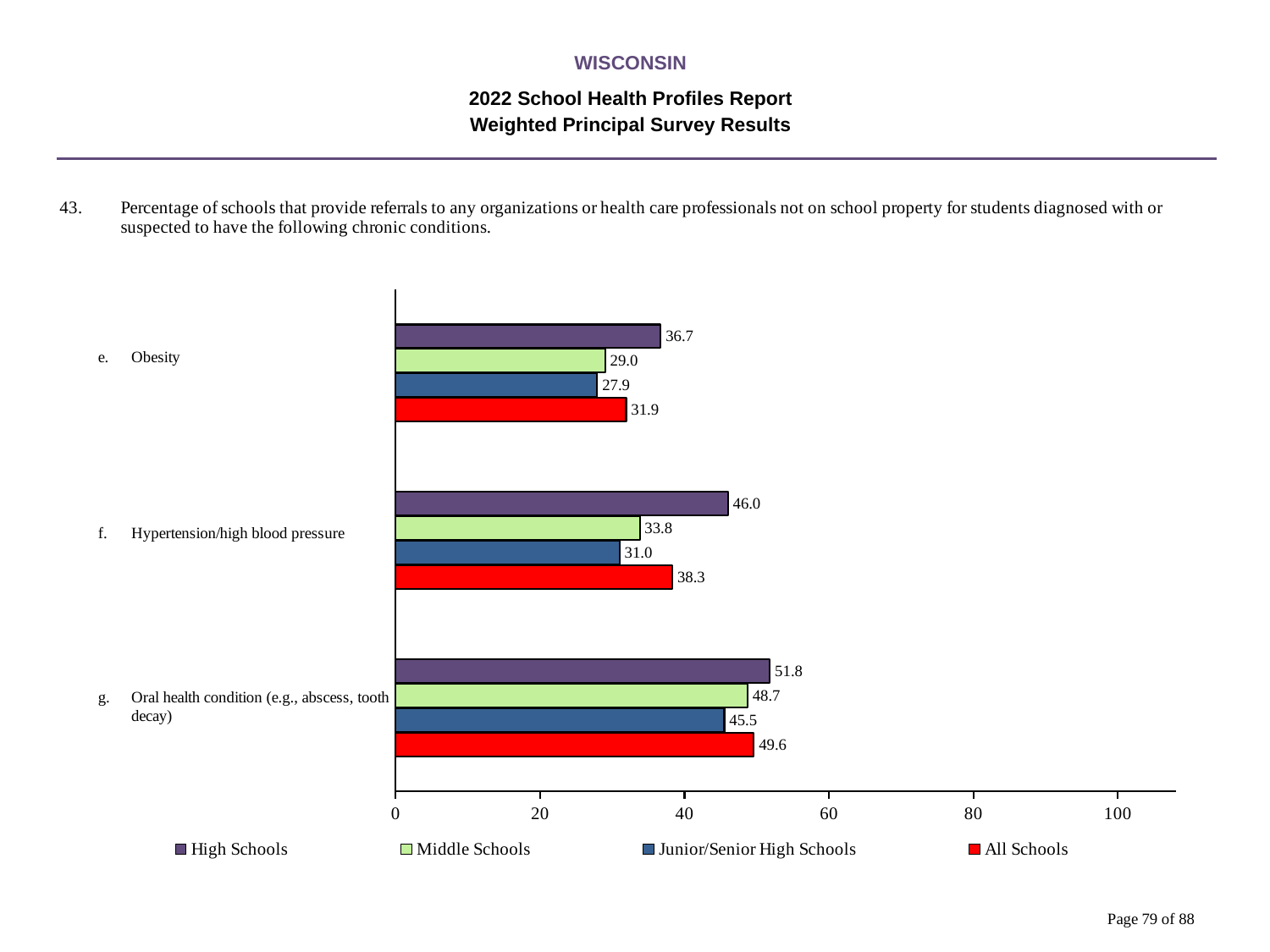
What kind of chart is shown on the slide? Bar chart What is the value for Junior/Senior High Schools for Oral health condition? 45.5 Is the value for High Schools for Oral health condition greater or less than 40? greater What is the difference between the High Schools and Middle Schools values for Hypertension/high blood pressure? 12.2 What is the value for All Schools for Hypertension/high blood pressure? 38.3 How many series does the legend list? 4 What is the value for Middle Schools for Hypertension/high blood pressure? 33.8 What is the value for High Schools for Obesity? 36.7 Which condition has the lowest value for All Schools? Obesity Which is larger for Obesity: the Middle Schools value or the Junior/Senior High Schools value? Middle Schools Which condition has the highest value for High Schools? Oral health condition (e.g., abscess, tooth decay) How many chronic conditions are shown on the chart? 3